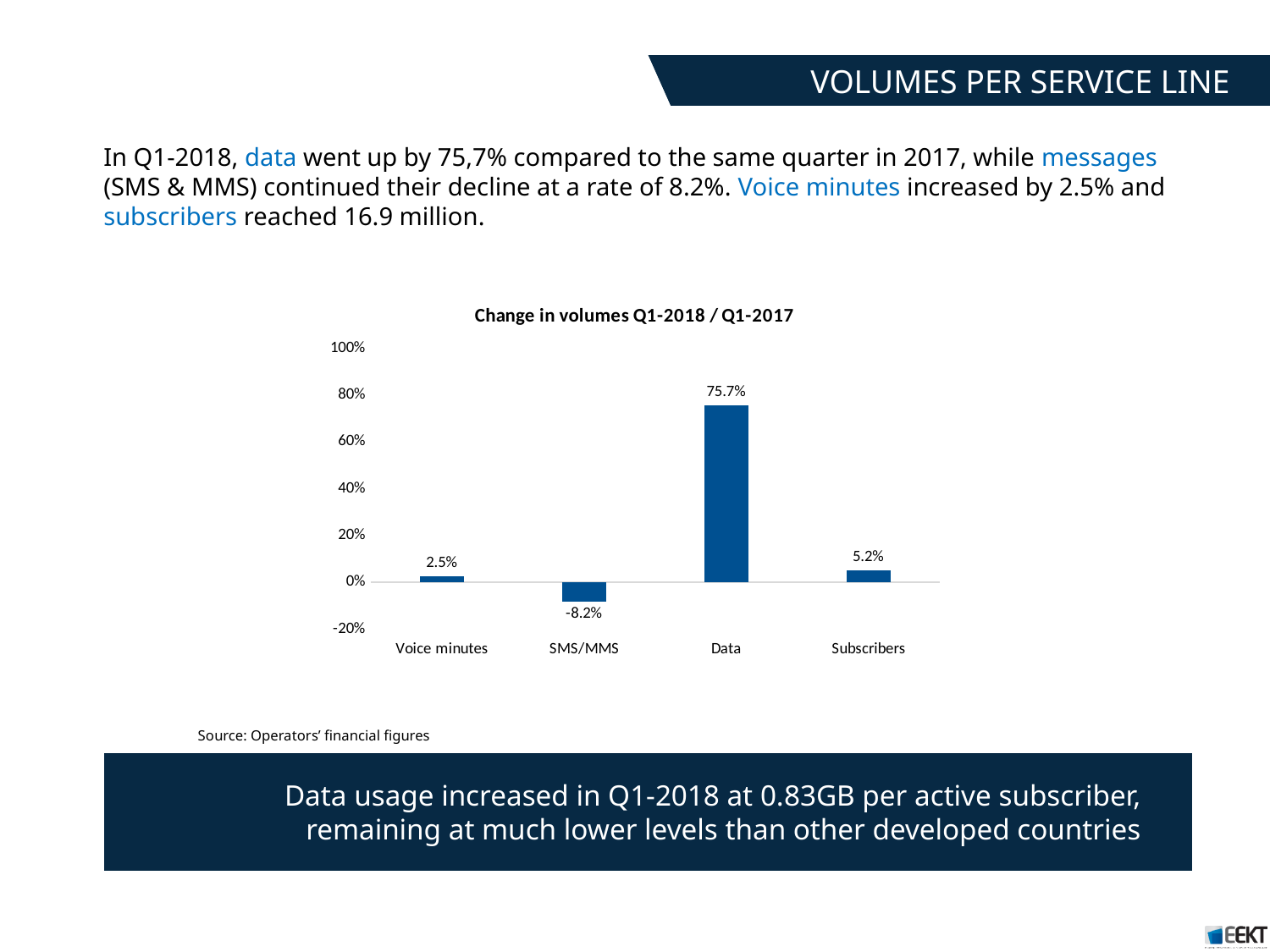
What is the value for Voice minutes in the chart? 2.5% What is the difference between the values for Data and Subscribers? 70.5% What is the value for Subscribers in the chart? 5.2% What is the value for SMS/MMS in the chart? -8.2% Which category has the lowest value? SMS/MMS What is the value for Data in the chart? 75.7% How many categories are shown on the x axis? 4 Which is larger, the value for Subscribers or the value for Voice minutes? Subscribers What kind of chart is shown on the slide? Bar chart What is the title of the chart? Change in volumes Q1-2018 / Q1-2017 Which category has the highest value? Data Is the value for Data greater or less than 60%? greater